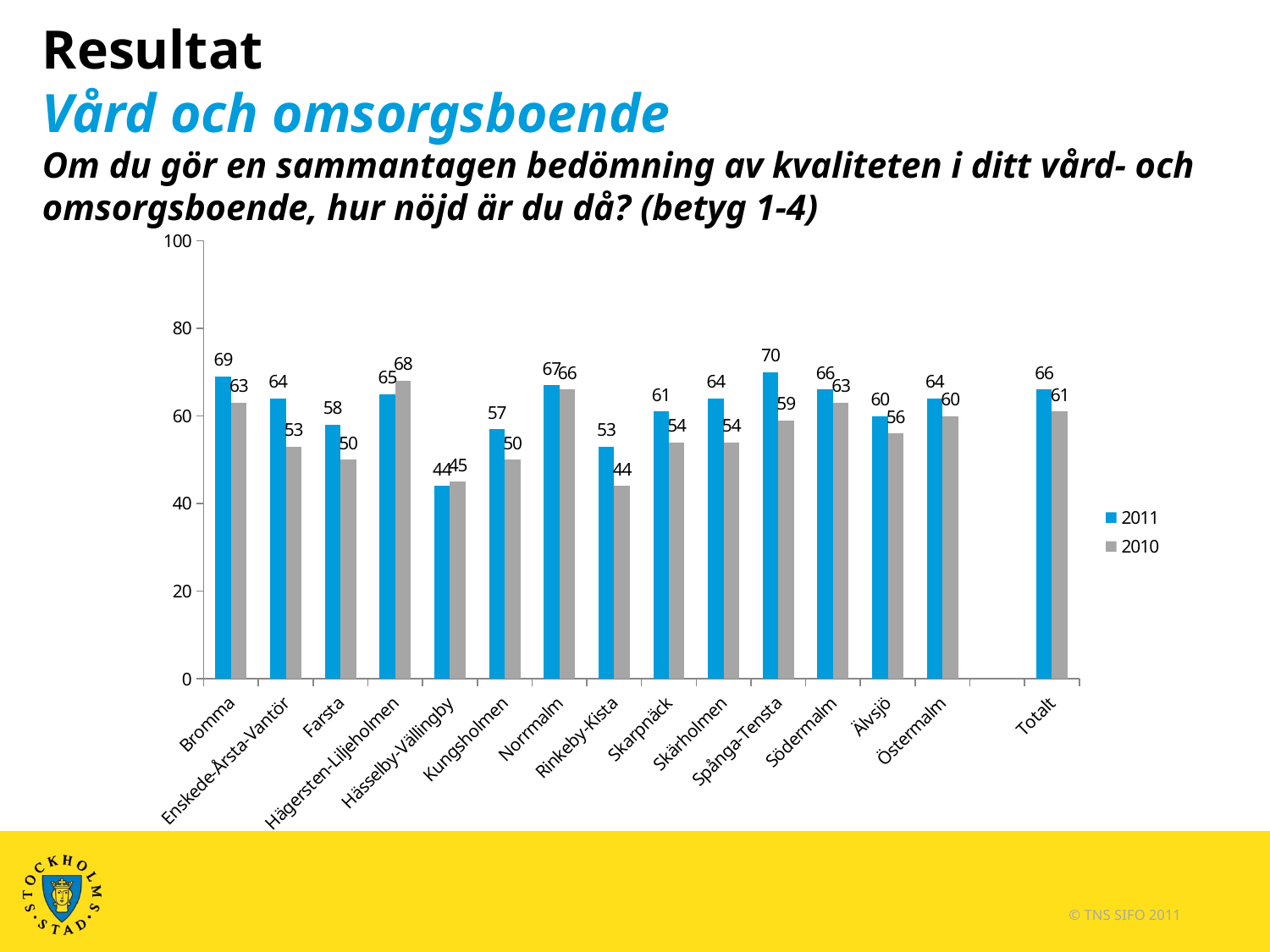
Which category has the highest 2011 value? Spånga-Tensta How many series does the legend list? 2 Which is larger for Hägersten-Liljeholmen, the 2011 value or the 2010 value? 2010 How many categories are shown on the x axis? 15 What is the 2011 value for Totalt? 66 What is the difference between the 2011 and 2010 values for Enskede-Årsta-Vantör? 11 What is the 2010 value for Enskede-Årsta-Vantör? 53 Which category has the highest 2010 value? Hägersten-Liljeholmen Is the 2011 value for Rinkeby-Kista greater or less than 60? less What kind of chart is shown on the slide? bar chart What is the 2011 value for Bromma? 69 Which category has the lowest 2011 value? Hässelby-Vällingby